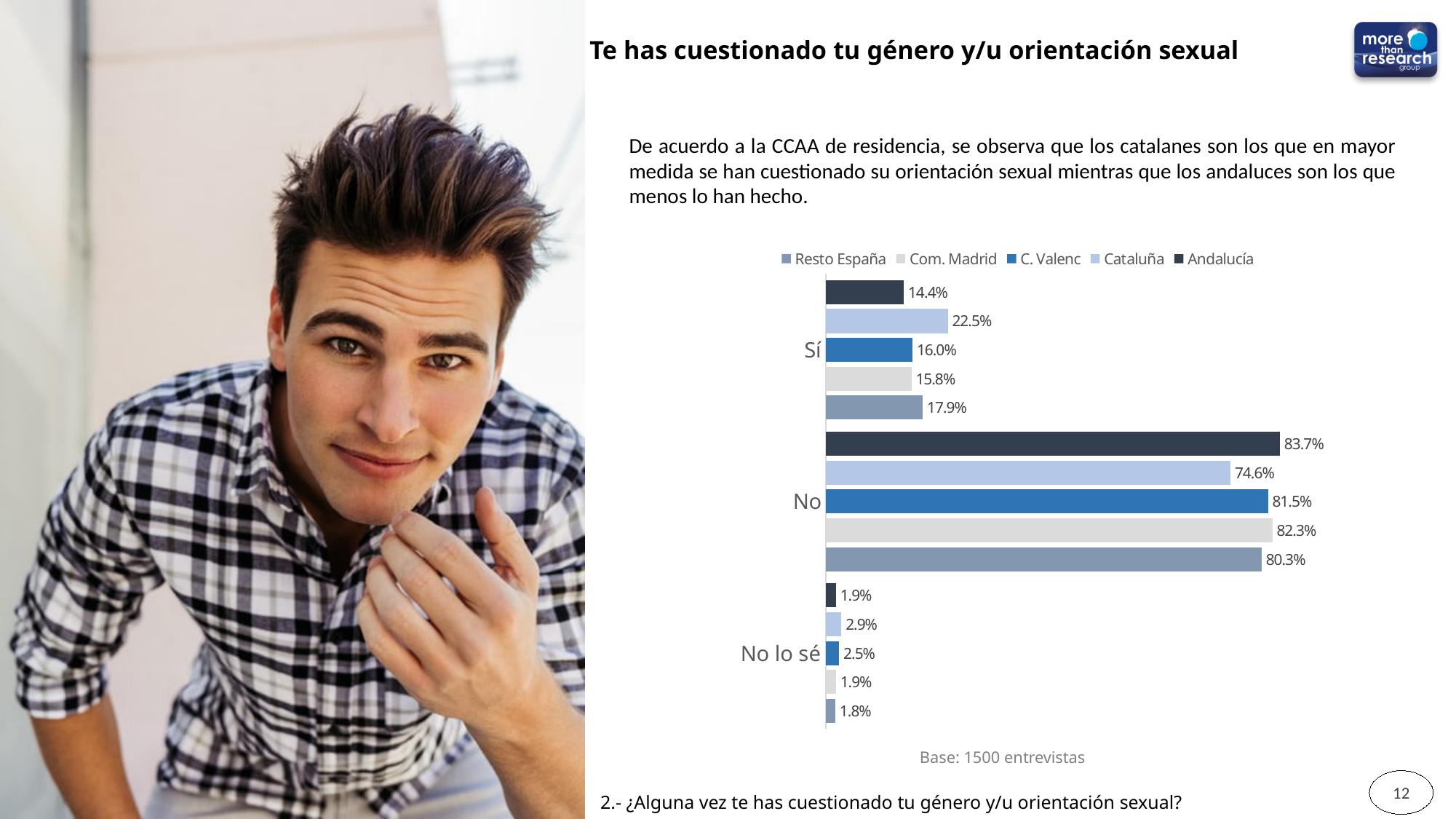
What kind of chart is shown on the slide? bar chart What is the value for Cataluña in the 'Sí' category? 22.5% What is the value for Resto España in the 'No lo sé' category? 1.8% What is the value for Andalucía in the 'No' category? 83.7% How many series does the chart legend list? 5 How many response categories are shown on the chart's axis? 3 What base (number of interviews) is stated below the chart? 1500 entrevistas Which region has the lowest value in the 'No' category? Cataluña Which region has the lowest value in the 'Sí' category? Andalucía Which region has the highest value in the 'Sí' category? Cataluña Which is larger in the 'No' category: Com. Madrid or Cataluña? Com. Madrid What is the difference between Cataluña and Andalucía in the 'Sí' category? 8.1%